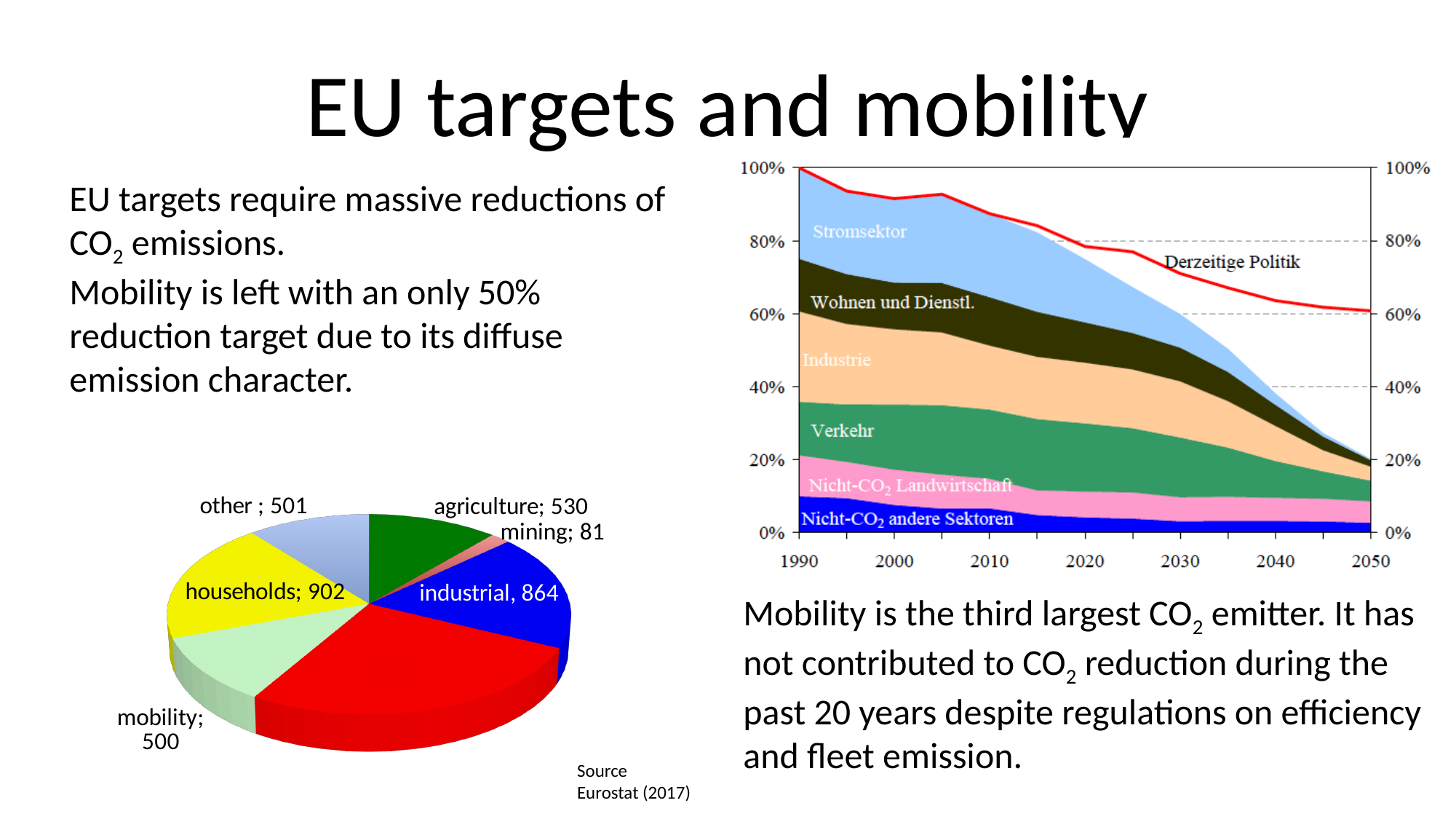
In the chart on the right, does the red 'Derzeitige Politik' line rise or fall from 1990 to 2050? fall How many slices does the pie chart on the left have? 7 In the pie chart, what is the value for households? 902 In the pie chart, what is the difference between the households value and the industrial value? 38 In the pie chart, which is larger, households or industrial? households In the pie chart, what is the value for mining? 81 What kind of chart is the chart on the left of the slide? pie chart In the pie chart, what is the value for agriculture? 530 What kind of chart is the chart on the right of the slide? area chart In the chart on the right, is the 'Derzeitige Politik' value in 2030 greater or less than 80%? less In the pie chart, which labeled category has the smallest value? mining In the pie chart, what is the difference between the agriculture value and the other value? 29